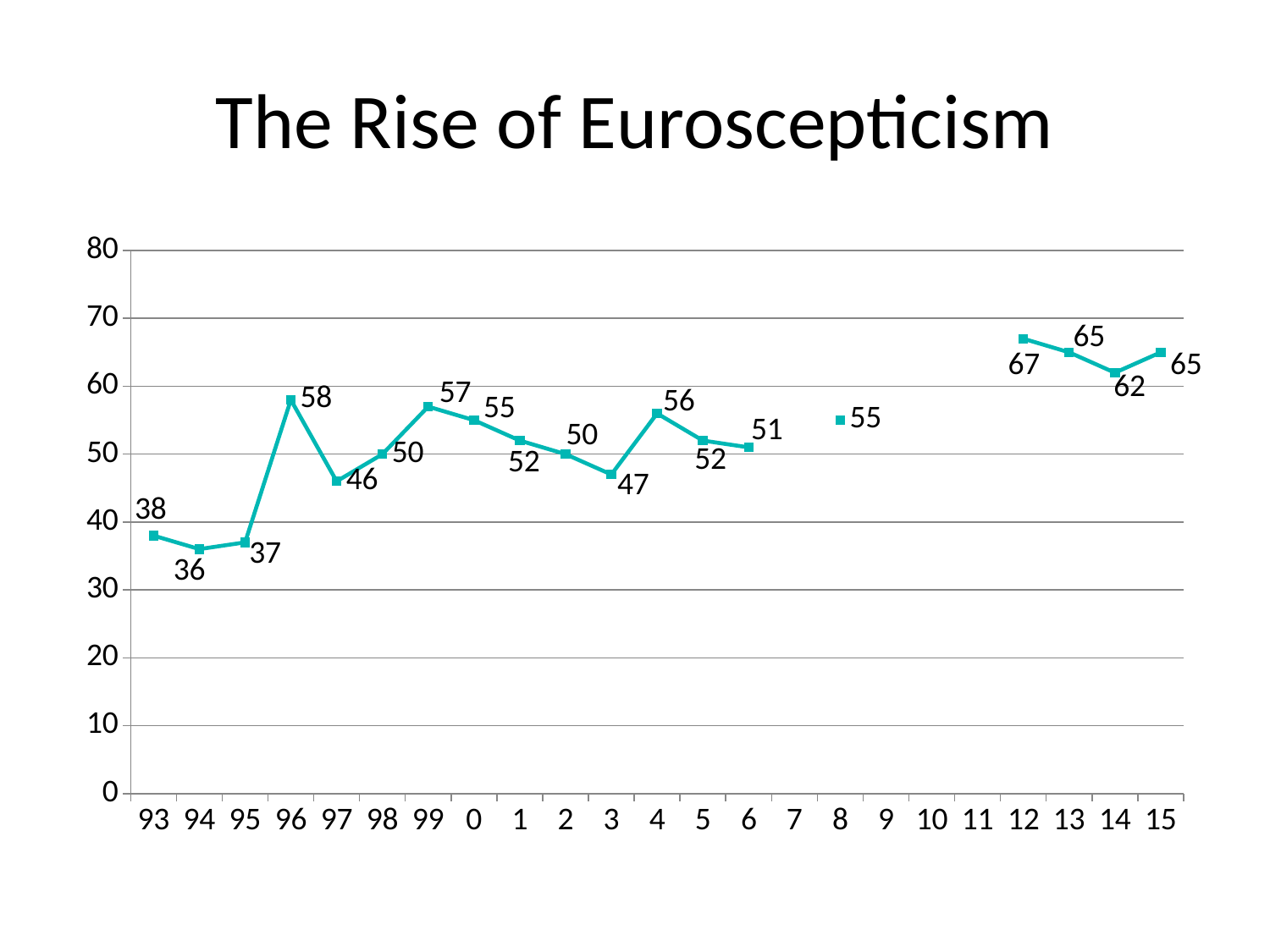
What is the title of the chart? The Rise of Euroscepticism What is the difference between the values for 96 and 97? 12 Which is larger, the value for 99 or the value for 4? 99 How many categories are shown on the x axis? 23 What is the value for 12? 67 Which year has the highest value? 12 What is the value for 8? 55 What is the difference between the values for 12 and 93? 29 Which year has the lowest value? 94 What kind of chart is shown on the slide? line chart What is the value for 96? 58 Is the value for 14 greater or less than 60? greater